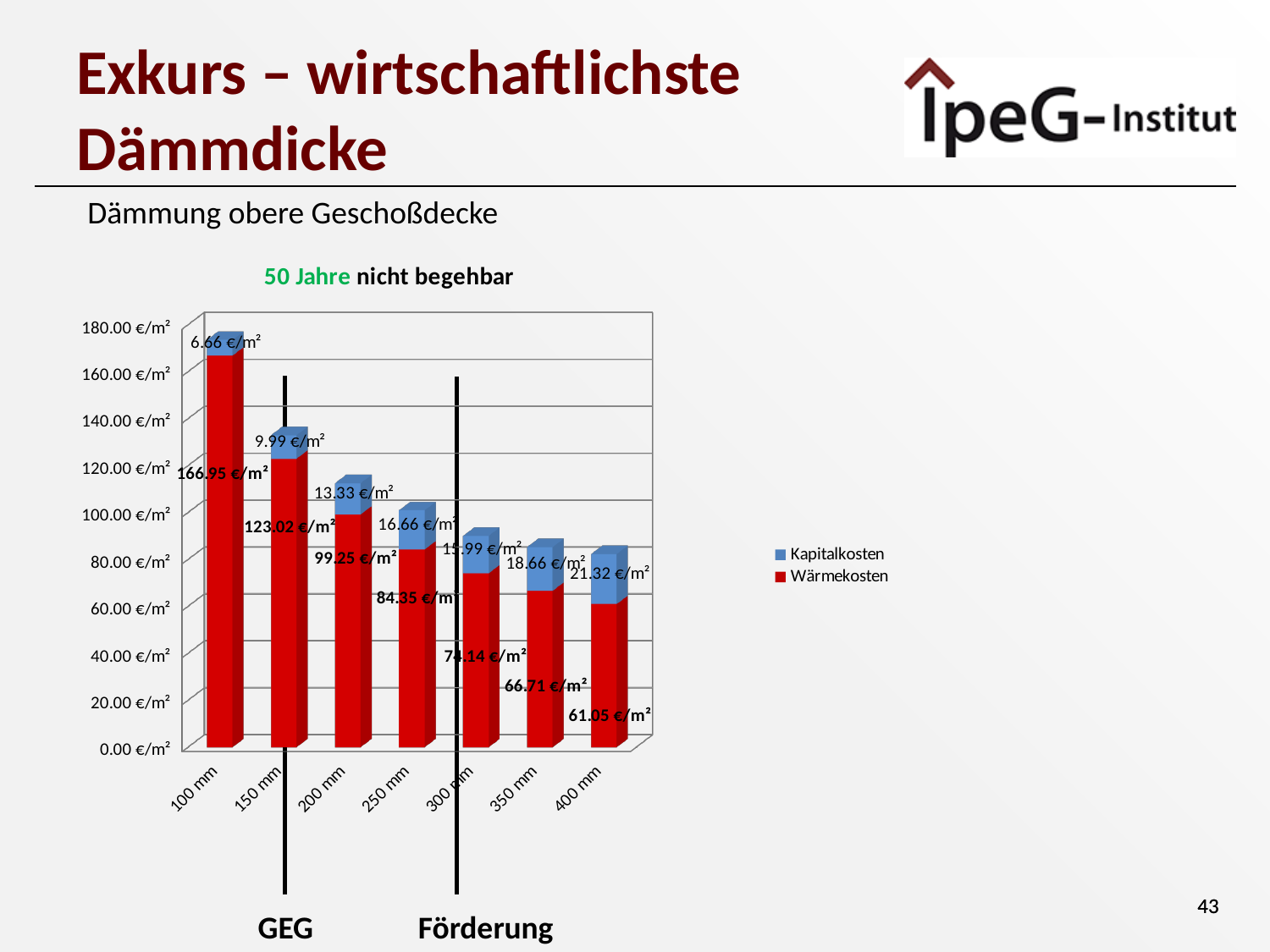
What kind of chart is shown on the slide? Stacked bar chart What is the Wärmekosten value for 100 mm? 166.95 €/m² What is the Kapitalkosten value for 200 mm? 13.33 €/m² Which insulation thickness has the highest Wärmekosten? 100 mm What is the difference between the Wärmekosten for 100 mm and 150 mm? 43.93 €/m² What is the total of the stacked bar for 400 mm? 82.37 €/m² How many insulation thickness categories are shown on the x axis? 7 Which is larger, the Kapitalkosten for 150 mm or for 350 mm? 350 mm What is the Kapitalkosten value for 400 mm? 21.32 €/m² What is the Wärmekosten value for 250 mm? 84.35 €/m² How many series does the legend list? 2 Which insulation thickness has the lowest Wärmekosten? 400 mm